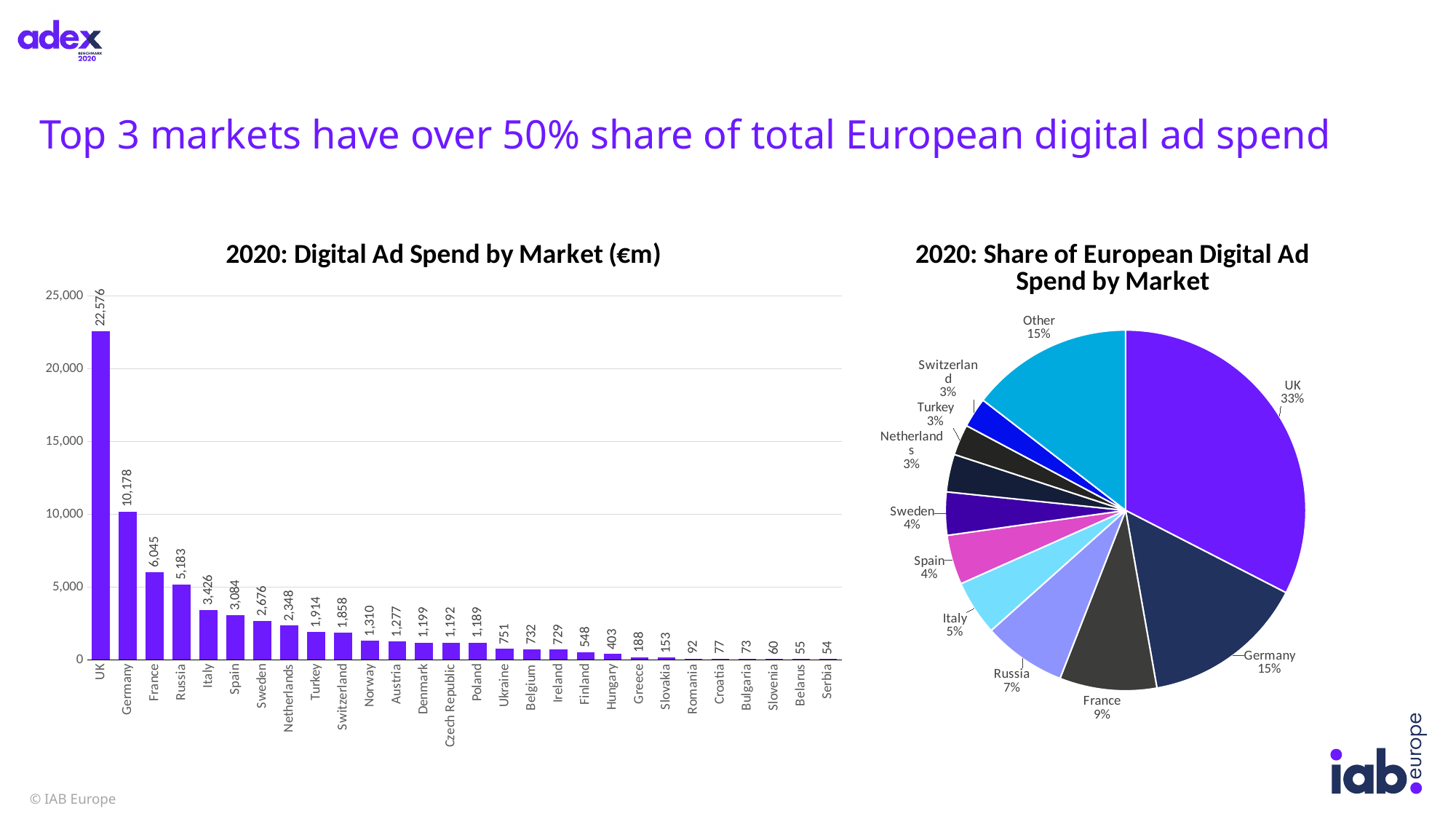
In the pie chart '2020: Share of European Digital Ad Spend by Market', what share does France have? 9% In the bar chart '2020: Digital Ad Spend by Market (€m)', which market has the lowest digital ad spend? Serbia How many markets are shown in the bar chart '2020: Digital Ad Spend by Market (€m)'? 28 What type of chart is '2020: Digital Ad Spend by Market (€m)'? Bar chart In the bar chart '2020: Digital Ad Spend by Market (€m)', which market has the highest digital ad spend? UK In the bar chart '2020: Digital Ad Spend by Market (€m)', do the values rise or fall from left to right along the x axis? Fall In the bar chart '2020: Digital Ad Spend by Market (€m)', which is larger, the value for Turkey or the value for Norway? Turkey In the bar chart '2020: Digital Ad Spend by Market (€m)', what is the value for Germany? 10,178 How many slices are in the pie chart '2020: Share of European Digital Ad Spend by Market'? 11 In the bar chart '2020: Digital Ad Spend by Market (€m)', what is the difference between the values for UK and Germany? 12,398 In the pie chart '2020: Share of European Digital Ad Spend by Market', what share does Russia have? 7% In the bar chart '2020: Digital Ad Spend by Market (€m)', what is the value for Netherlands? 2,348